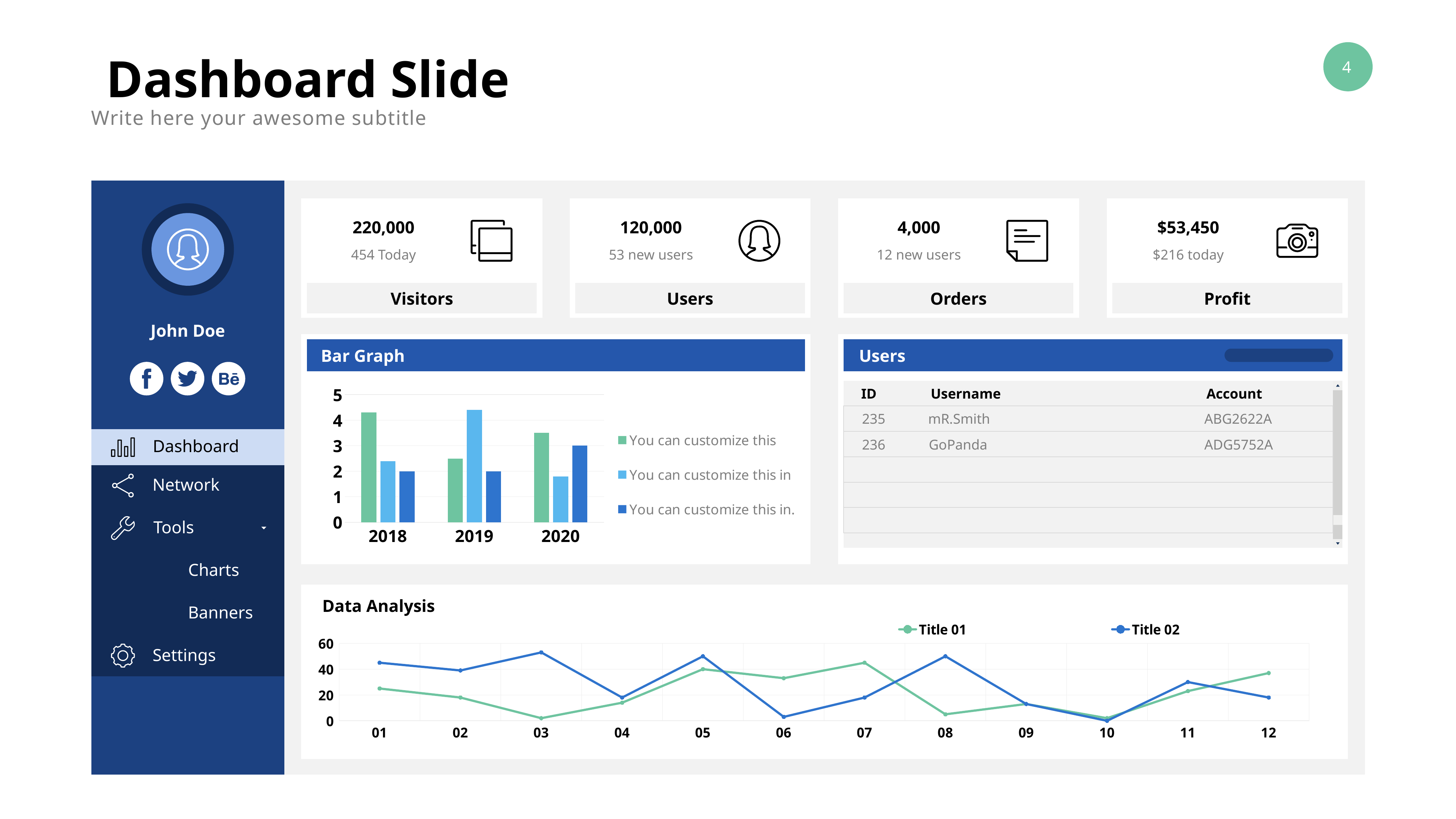
In the Bar Graph chart, which series has the shortest bar for 2020? You can customize this in How many series does the legend of the Bar Graph chart list? 3 In the Data Analysis chart, which series has the larger value at 06, Title 01 or Title 02? Title 01 In the Data Analysis chart, is the value of Title 02 at 03 greater or less than 40? greater In the Data Analysis chart, at which x-axis point does Title 01 reach its highest value? 07 How many points are shown along the x axis of the Data Analysis chart? 12 How many series does the legend of the Data Analysis chart list? 2 How many categories are shown on the x axis of the Bar Graph chart? 3 What kind of chart is the Data Analysis chart? line chart In the Bar Graph chart, which series has the tallest bar for 2019? You can customize this in What kind of chart is the Bar Graph chart? bar chart In the Bar Graph chart, is the value of the green series for 2018 greater or less than 4? greater